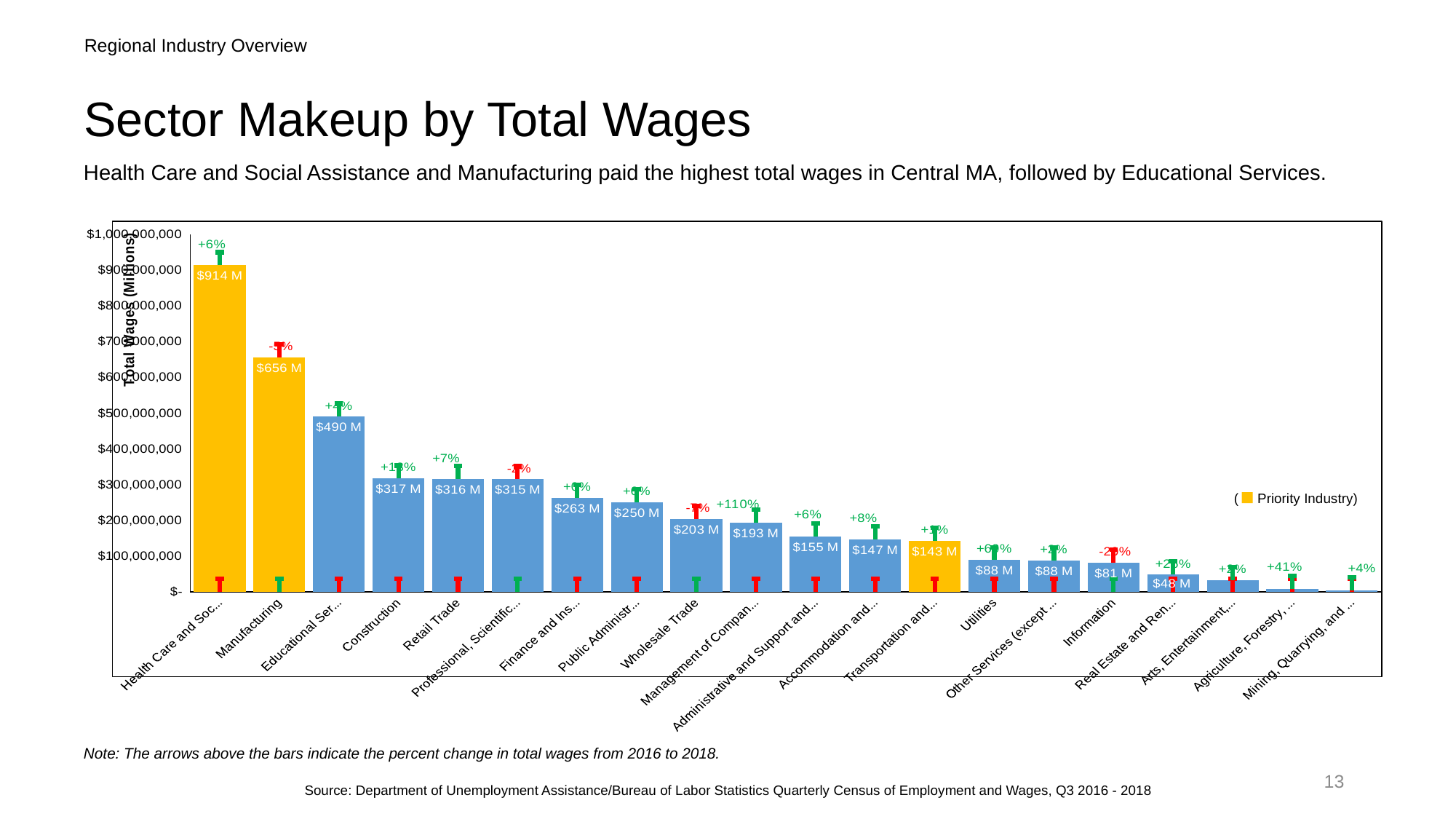
What is the total wages value shown for Construction? $317 M Which sector has the highest total wages? Health Care and Social Assistance How many sectors are plotted in the chart? 20 Is the total wages value for Arts, Entertainment greater or less than $100,000,000? less What percent change in total wages is shown above the Management of Companies bar? +110% Which has higher total wages, Wholesale Trade or Management of Companies? Wholesale Trade What is the difference in total wages between Health Care and Social Assistance and Manufacturing? $258 M Which sector has the lowest total wages? Mining, Quarrying, and ... Do the total wages values rise or fall moving from left to right along the x axis? fall What is the total wages value shown for Wholesale Trade? $203 M What kind of chart is shown on the slide? bar chart What is the total wages value shown for Manufacturing? $656 M